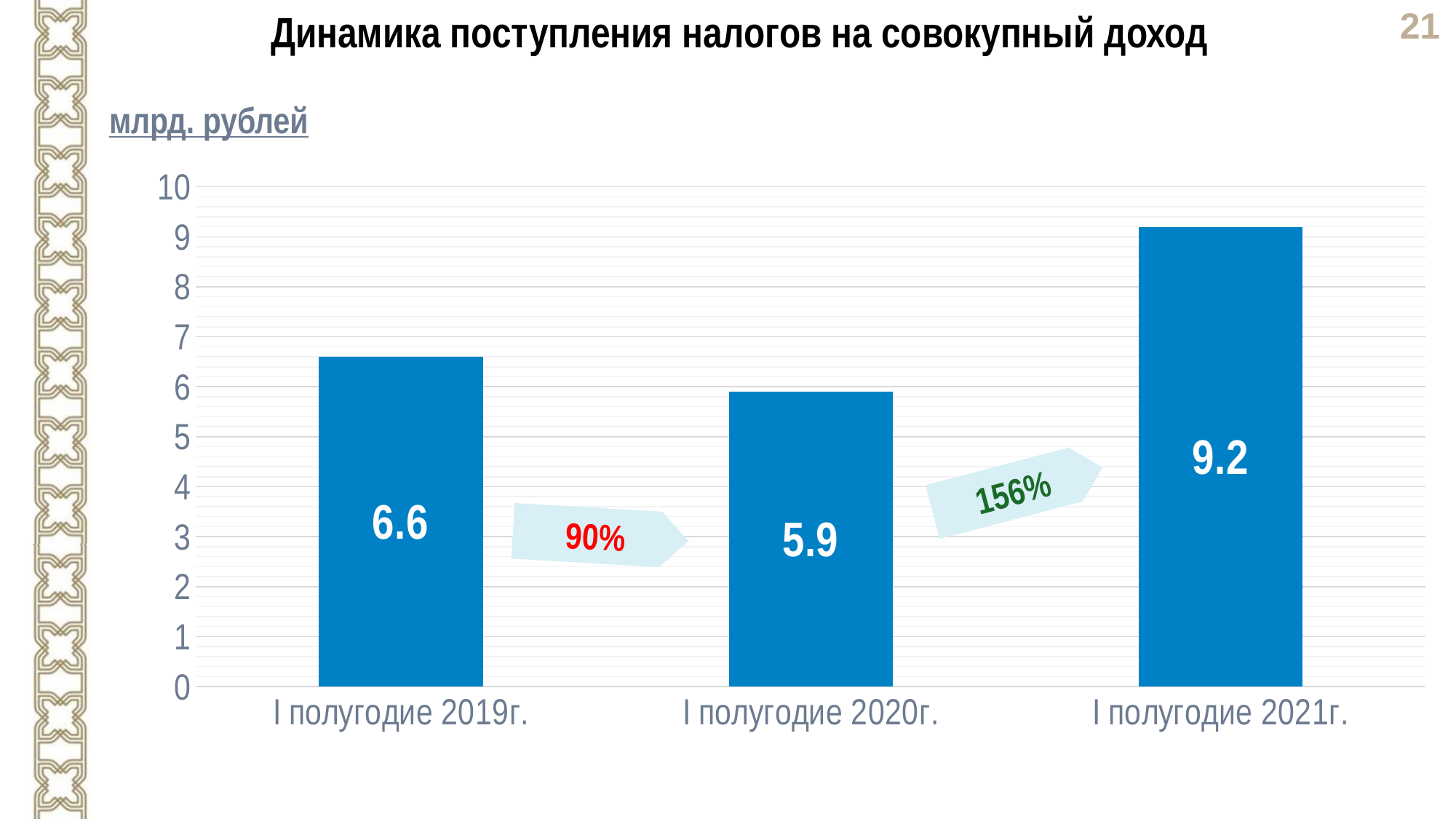
How many periods are shown on the chart? 3 What is the value for I полугодие 2019г.? 6.6 Which period has the lowest value? I полугодие 2020г. What unit is stated above the chart? млрд. рублей Is the value for I полугодие 2021г. greater or less than 8? greater What kind of chart is shown on the slide? bar chart What is the difference between the values for I полугодие 2019г. and I полугодие 2020г.? 0.7 Which period has the highest value? I полугодие 2021г. What is the difference between the values for I полугодие 2021г. and I полугодие 2020г.? 3.3 What is the value for I полугодие 2020г.? 5.9 What is the value for I полугодие 2021г.? 9.2 Which is larger, the value for I полугодие 2019г. or I полугодие 2021г.? I полугодие 2021г.